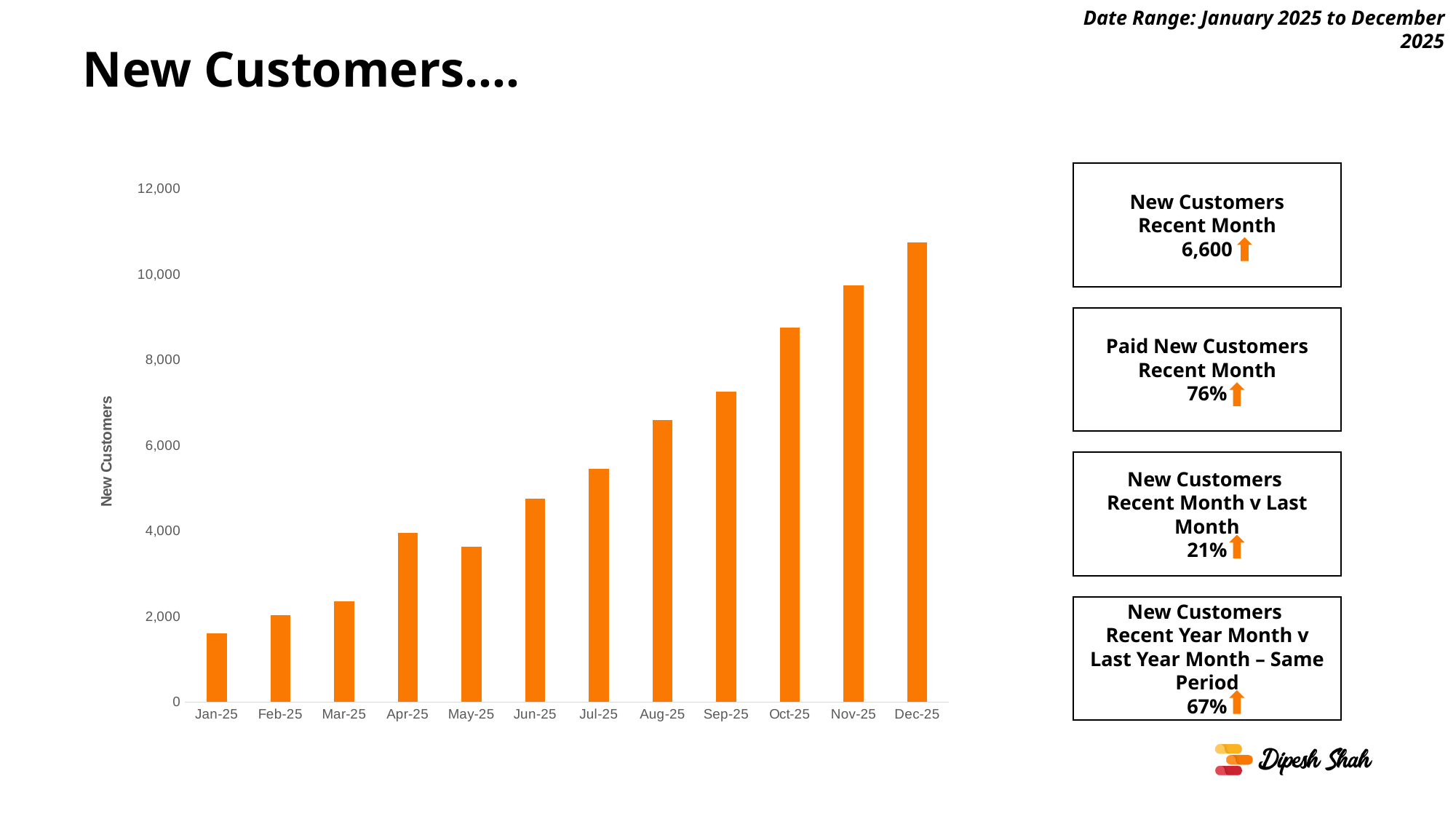
Is the value for Aug-25 greater or less than 6,000? greater Is the value for Jan-25 greater or less than 2,000? less Is the value for Dec-25 greater or less than 10,000? greater Which month has the larger value, Feb-25 or Mar-25? Mar-25 How many months are plotted on the x axis of the chart? 12 Which month has the highest number of new customers in the chart? Dec-25 Which month has the lowest number of new customers in the chart? Jan-25 What is the title of the vertical axis of the chart? New Customers Which month has the larger value, Apr-25 or May-25? Apr-25 Do the values in the chart generally rise or fall from Jan-25 to Dec-25? Rise What kind of chart is shown on the slide? Bar chart